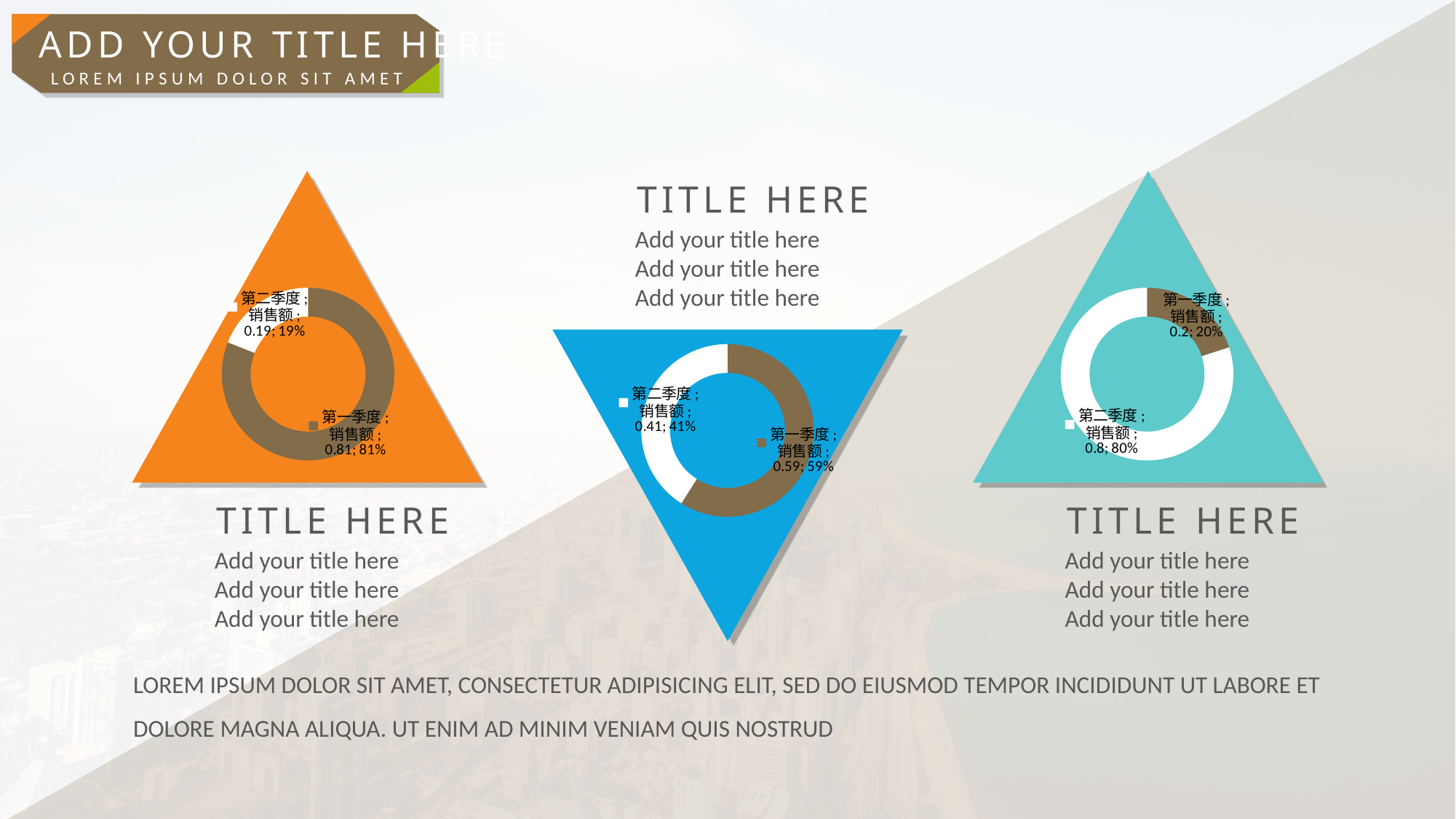
How many categories does the middle chart show? 2 In the right chart, what percentage share does 第一季度 销售额 have? 20% In the right chart, what value is shown for 第二季度 销售额? 0.8 In the left chart, what percentage share does 第二季度 销售额 have? 19% In the middle chart, what is the difference between the 第一季度 and 第二季度 values? 0.18 In the middle chart, what percentage share does 第一季度 销售额 have? 59% In the left chart, what value is shown for 第一季度 销售额? 0.81 In the middle chart, what value is shown for 第二季度 销售额? 0.41 In the right chart, which category has the smallest share? 第一季度 What colour is the triangle containing the middle chart? blue In the left chart, which category has the larger share, 第一季度 or 第二季度? 第一季度 What kind of chart is shown inside the left orange triangle? doughnut chart